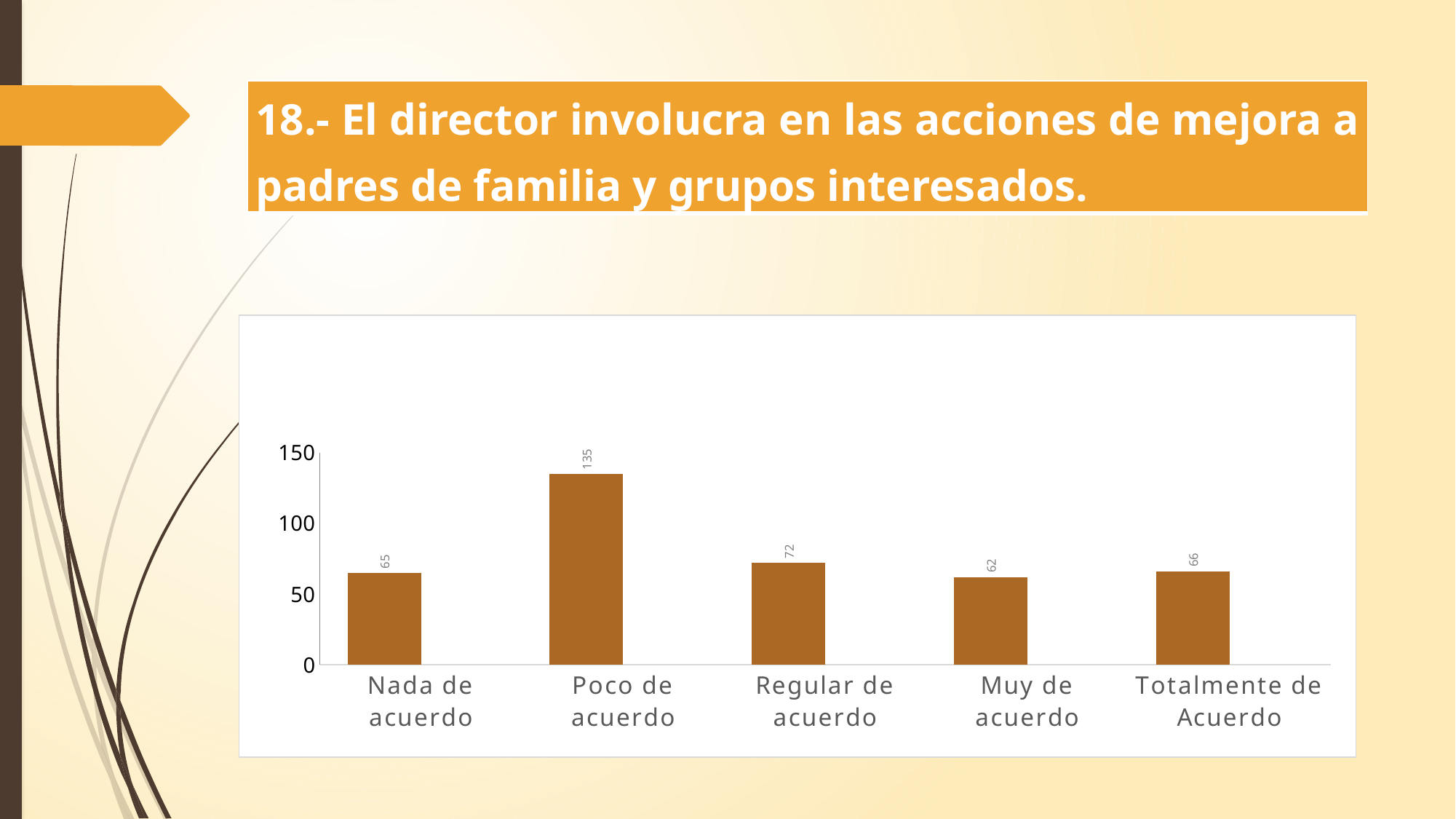
Which category has the lowest value? Muy de acuerdo What is the value for "Totalmente de Acuerdo"? 66 What kind of chart is shown on the slide? bar chart What is the difference between the values for "Poco de acuerdo" and "Regular de acuerdo"? 63 What is the value for "Nada de acuerdo"? 65 What is the value for "Poco de acuerdo"? 135 What is the value for "Muy de acuerdo"? 62 What is the value for "Regular de acuerdo"? 72 Which is larger, the value for "Regular de acuerdo" or the value for "Totalmente de Acuerdo"? Regular de acuerdo How many categories are shown on the x axis? 5 Is the value for "Poco de acuerdo" greater or less than 100? greater Which category has the highest value? Poco de acuerdo